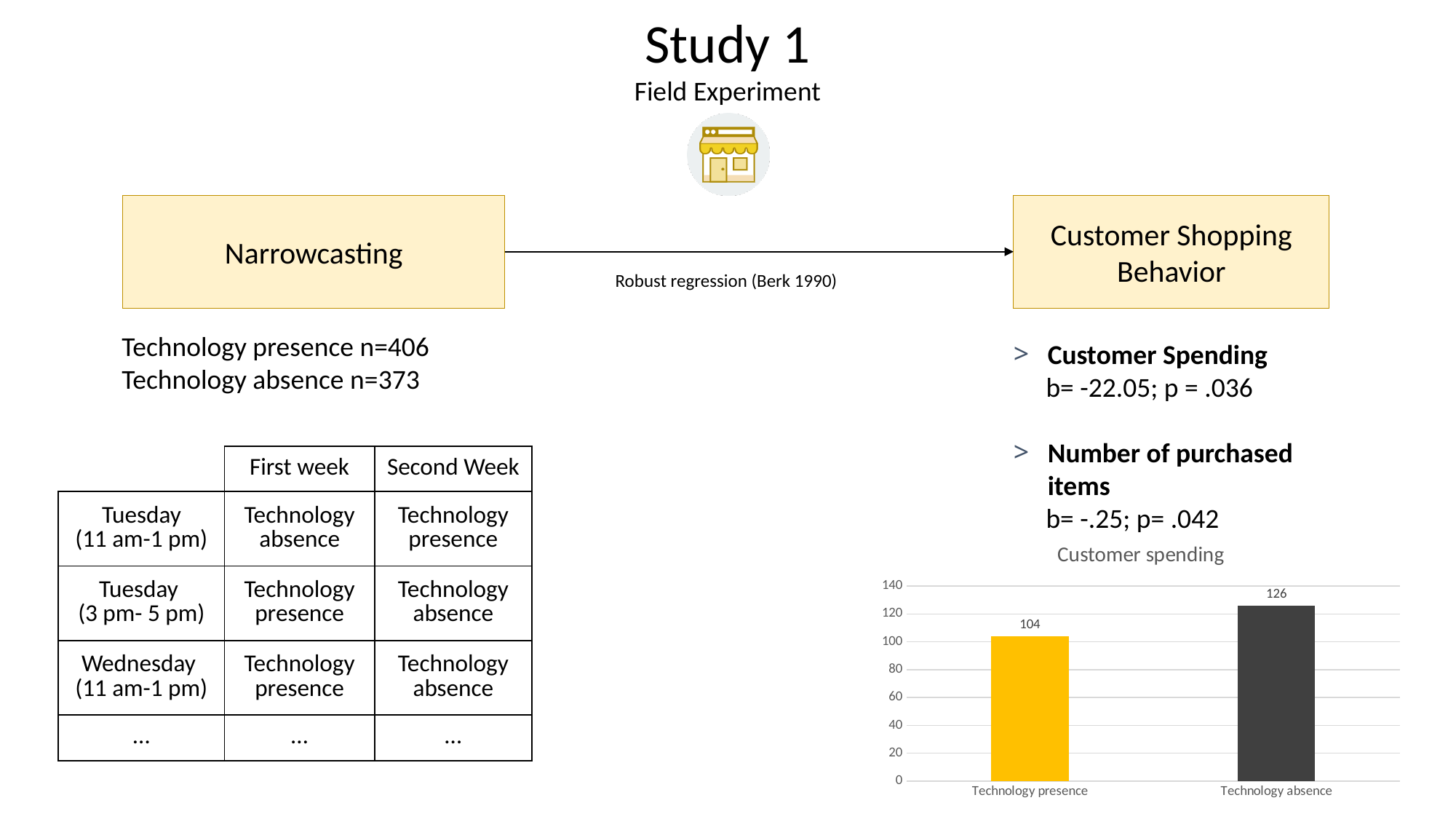
Which category has the highest value in the Customer spending chart? Technology absence Which category has the lowest value in the Customer spending chart? Technology presence What is the value for Technology presence in the Customer spending chart? 104 What is the title of the chart on the slide? Customer spending How many categories are shown in the Customer spending chart? 2 What colour is the Technology presence bar in the Customer spending chart? yellow Is the value for Technology absence in the Customer spending chart greater or less than 120? greater What kind of chart is the Customer spending chart? bar chart What is the difference between the Technology absence and Technology presence values in the Customer spending chart? 22 In the Customer spending chart, is the value for Technology presence or Technology absence larger? Technology absence Is the value for Technology presence in the Customer spending chart greater or less than 120? less What is the value for Technology absence in the Customer spending chart? 126